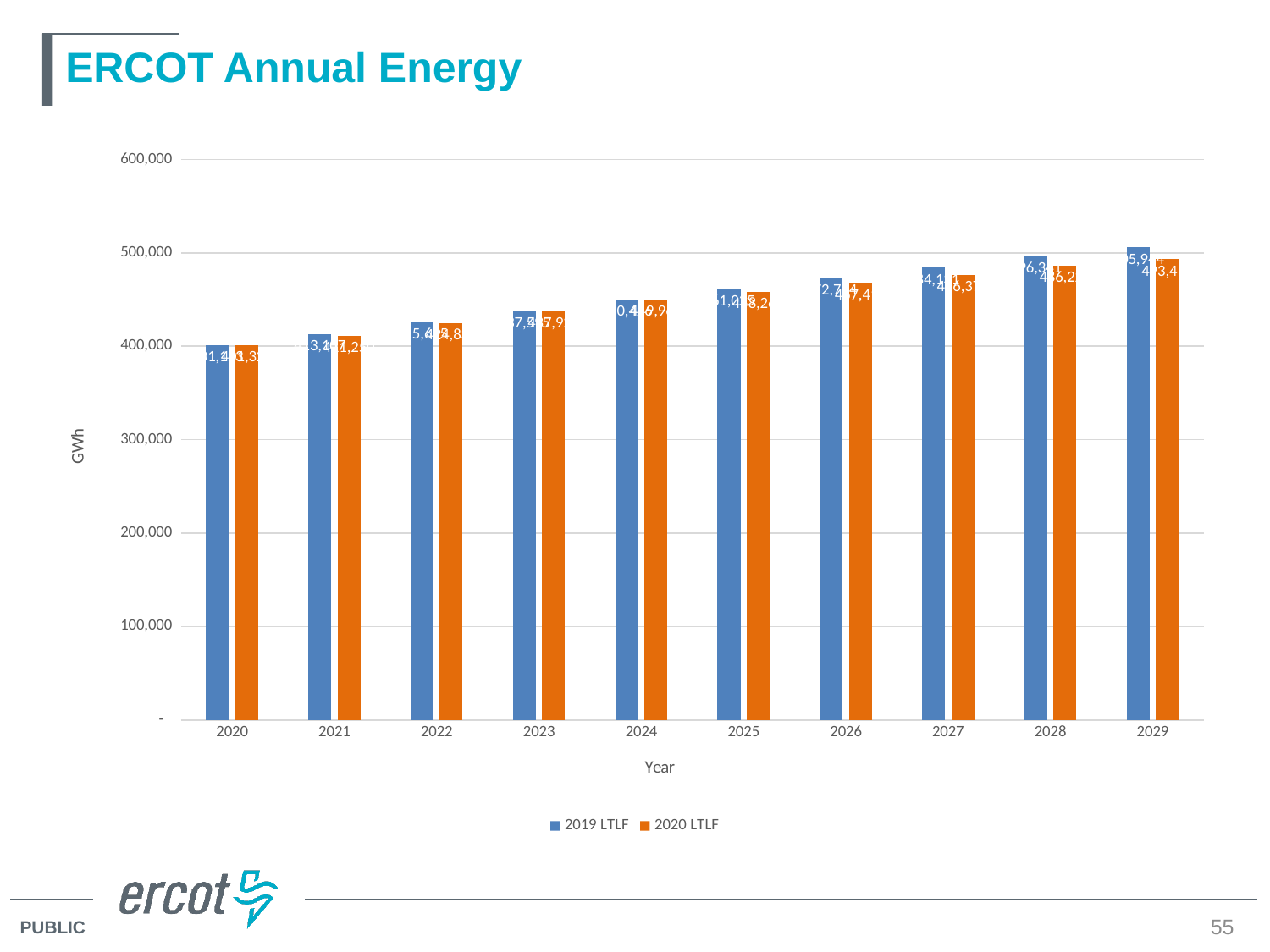
Is the 2020 LTLF value for 2025 greater or less than 500,000? less Is the 2019 LTLF value for 2025 greater or less than 400,000? greater Which year has the highest 2019 LTLF value? 2029 Do the 2020 LTLF values rise or fall from 2020 to 2029? rise Is the 2020 LTLF value for 2020 greater or less than 500,000? less What kind of chart is shown on the slide? bar chart What unit is shown on the y axis label? GWh How many years are shown on the x axis? 10 Which year has the lowest 2020 LTLF value? 2020 Which is larger for the 2020 LTLF series: the value for 2029 or the value for 2020? 2029 How many series does the legend list? 2 Which colour represents the 2020 LTLF series? orange